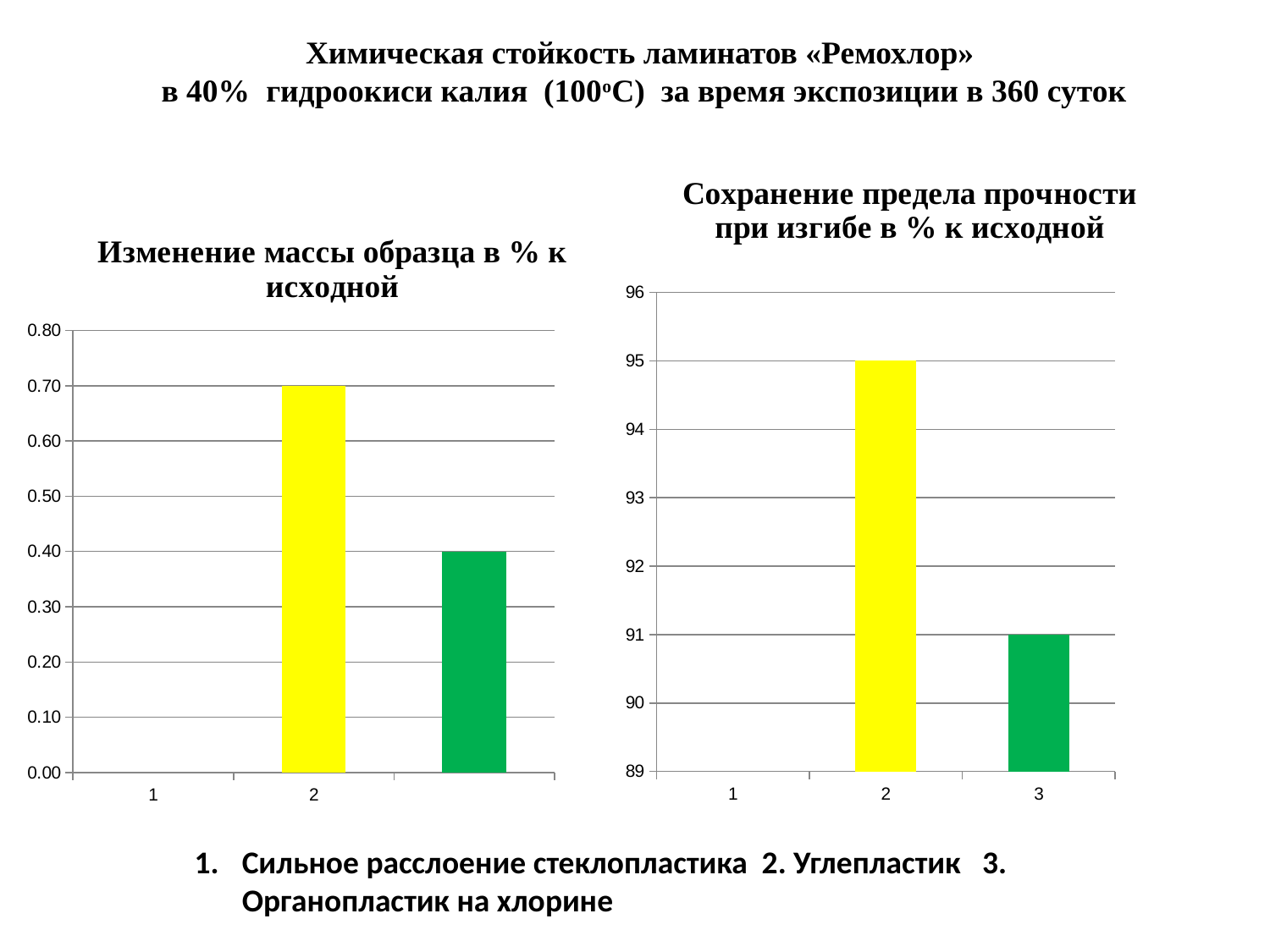
In the chart titled «Сохранение предела прочности при изгибе в % к исходной», is the value for category 3 greater or less than 92? less In the chart titled «Сохранение предела прочности при изгибе в % к исходной», what is the difference between the values for category 2 and category 3? 4 In the chart titled «Сохранение предела прочности при изгибе в % к исходной», how many categories are labelled on the x axis? 3 In the chart titled «Изменение массы образца в % к исходной», what value does the green bar reach? 0.40 In the chart titled «Изменение массы образца в % к исходной», is the value for category 2 greater or less than 0.60? greater What type of chart is the chart on the right of the slide? bar chart In the chart titled «Изменение массы образца в % к исходной», what is the difference between the yellow bar and the green bar? 0.30 In the chart titled «Сохранение предела прочности при изгибе в % к исходной», which category has the highest value? 2 In the chart titled «Сохранение предела прочности при изгибе в % к исходной», which is larger, the value for category 2 or category 3? category 2 In the chart titled «Сохранение предела прочности при изгибе в % к исходной», what is the value for category 2? 95 In the chart titled «Сохранение предела прочности при изгибе в % к исходной», what is the value for category 3? 91 In the chart titled «Изменение массы образца в % к исходной», what is the value for category 2? 0.70